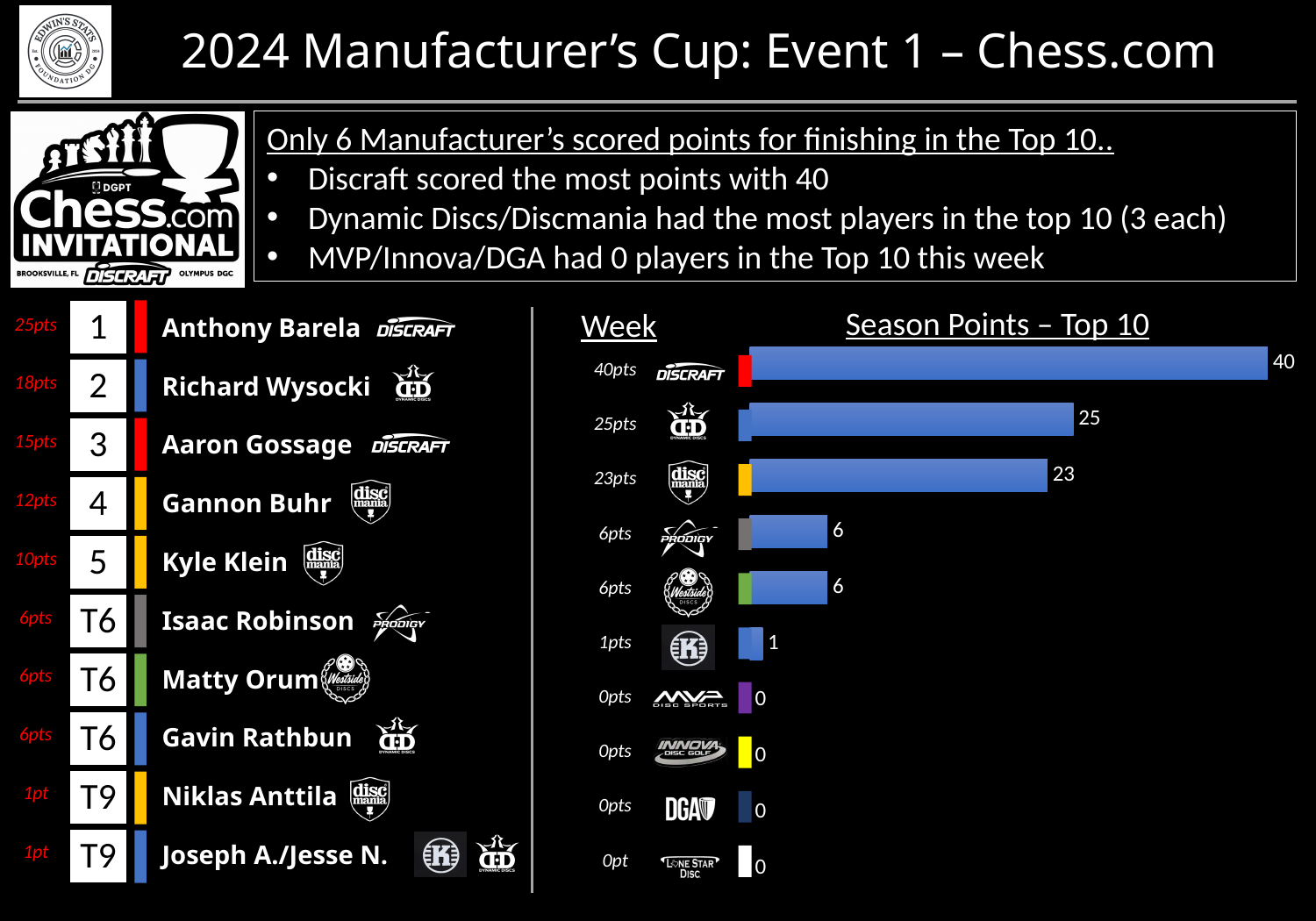
What kind of chart is the Season Points – Top 10 chart? Bar chart How many manufacturers are shown in the Season Points – Top 10 chart? 10 In the Season Points – Top 10 chart, which manufacturer has the highest season points? Discraft In the Season Points – Top 10 chart, which has more season points, Dynamic Discs or Discmania? Dynamic Discs In the Season Points – Top 10 chart, what value is shown for Innova? 0 In the Season Points – Top 10 chart, what value is shown for Discraft? 40 In the Season Points – Top 10 chart, how many manufacturers have 0 season points? 4 In the Season Points – Top 10 chart, what value is shown for Discmania? 23 What is the title of the chart on the right side of the slide? Season Points – Top 10 In the Season Points – Top 10 chart, what value is shown for Prodigy? 6 In the Season Points – Top 10 chart, what is the difference between Discraft's and Discmania's season points? 17 In the Season Points – Top 10 chart, what is the difference between Dynamic Discs' and Westside Discs' season points? 19